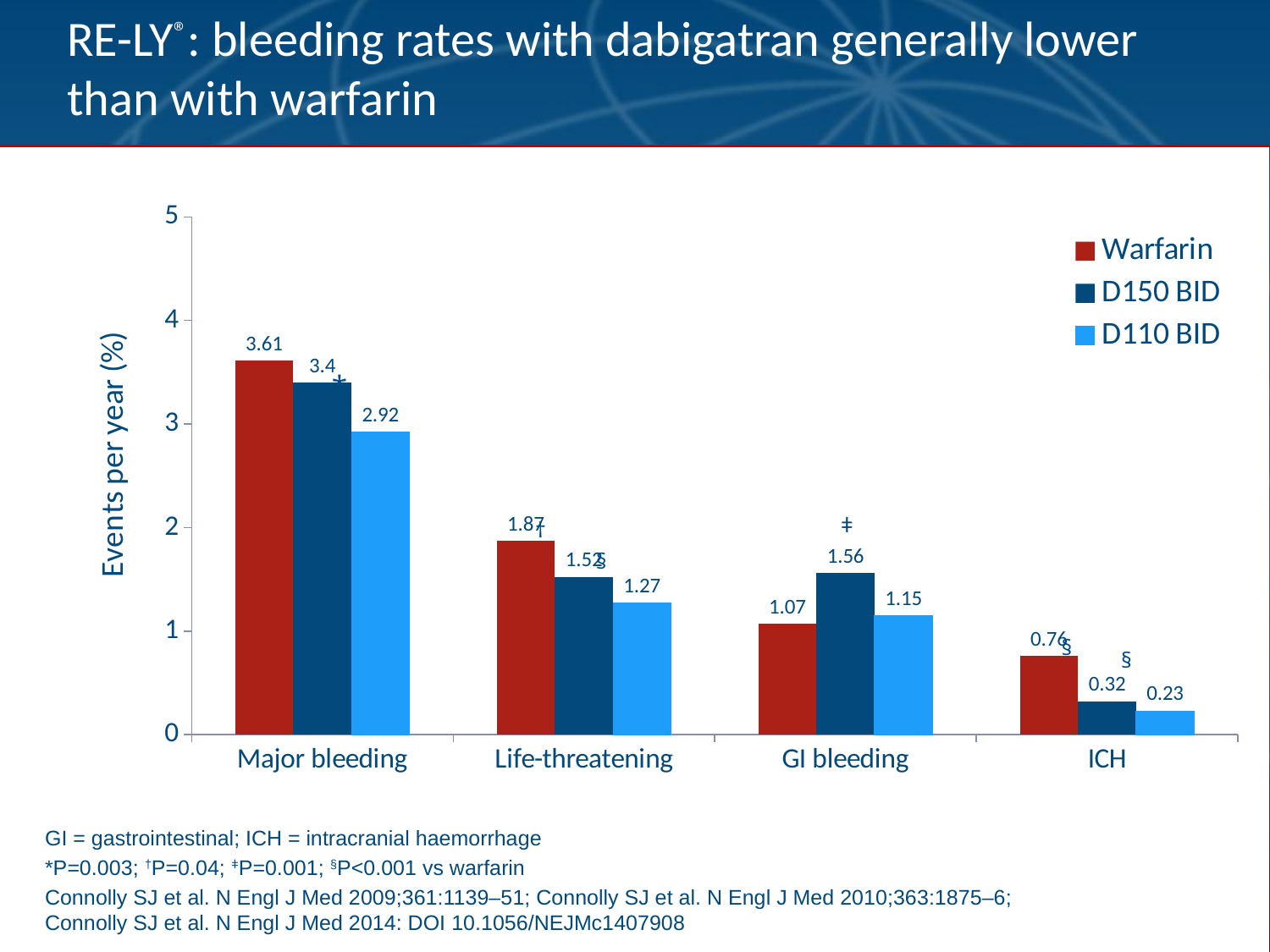
What is the D110 BID value for ICH? 0.23 Which category has the highest Warfarin value? Major bleeding What is the difference between the Warfarin and D110 BID values for Major bleeding? 0.69 What kind of chart is shown on the slide? bar chart What is the D110 BID value for Major bleeding? 2.92 For GI bleeding, which is larger: the Warfarin value or the D150 BID value? D150 BID How many categories are shown on the x axis? 4 What is the Warfarin value for Major bleeding? 3.61 Which category has the lowest D150 BID value? ICH Is the Warfarin value for Life-threatening greater or less than 2? less What is the D150 BID value for GI bleeding? 1.56 How many series does the legend list? 3